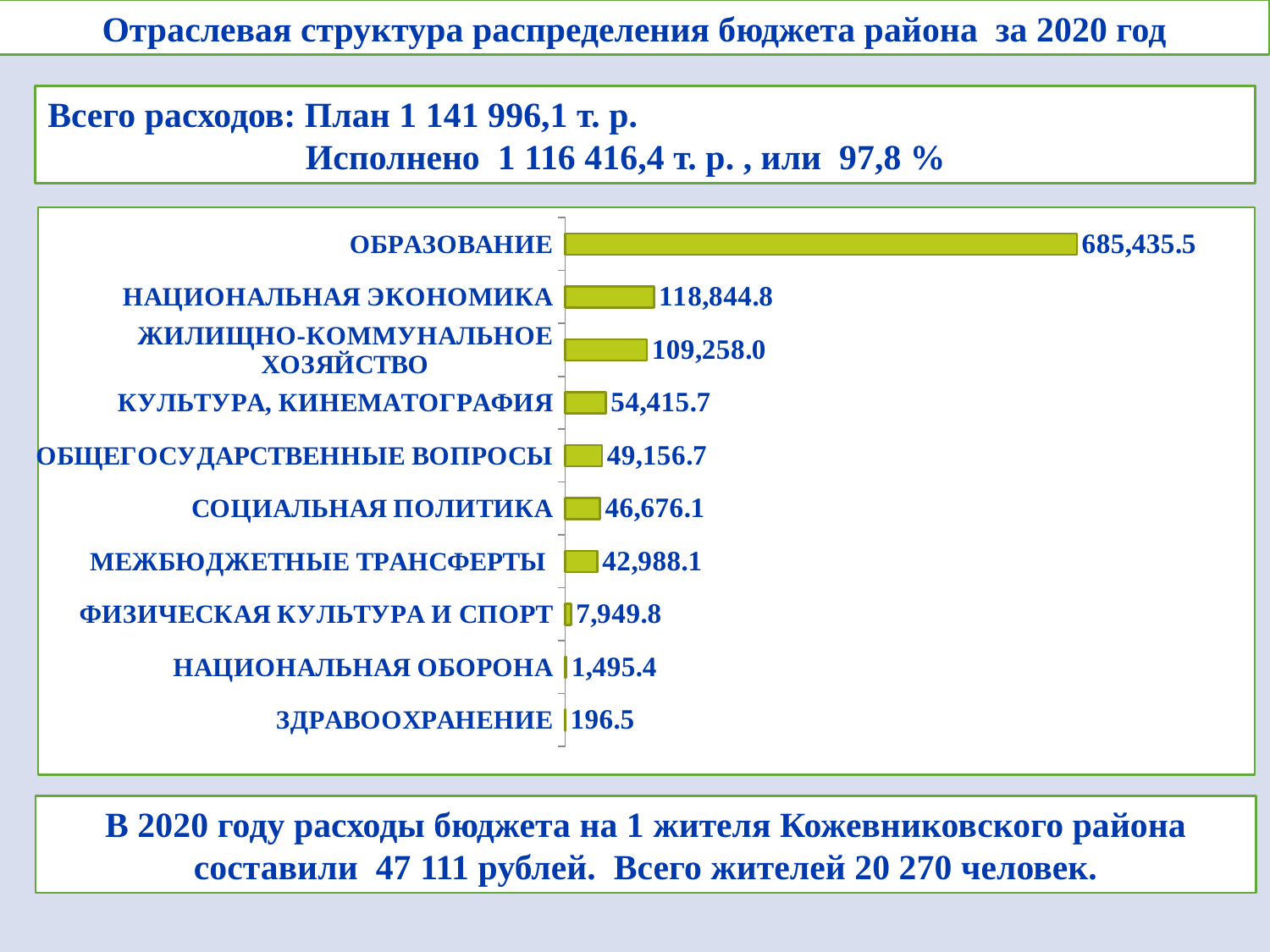
What is the difference between НАЦИОНАЛЬНАЯ ЭКОНОМИКА and ЖИЛИЩНО-КОММУНАЛЬНОЕ ХОЗЯЙСТВО? 9,586.8 Which category has the lowest value? ЗДРАВООХРАНЕНИЕ Do the values increase or decrease going from the top category to the bottom category? Decrease How many categories are shown in the chart? 10 Which is larger, СОЦИАЛЬНАЯ ПОЛИТИКА or ФИЗИЧЕСКАЯ КУЛЬТУРА И СПОРТ? СОЦИАЛЬНАЯ ПОЛИТИКА What is the value for ЗДРАВООХРАНЕНИЕ? 196.5 What is the difference between КУЛЬТУРА, КИНЕМАТОГРАФИЯ and ОБЩЕГОСУДАРСТВЕННЫЕ ВОПРОСЫ? 5,259.0 What kind of chart is shown on the slide? Bar chart What is the value for МЕЖБЮДЖЕТНЫЕ ТРАНСФЕРТЫ? 42,988.1 Which category has the highest value? ОБРАЗОВАНИЕ What is the value for ОБРАЗОВАНИЕ? 685,435.5 What is the value for ЖИЛИЩНО-КОММУНАЛЬНОЕ ХОЗЯЙСТВО? 109,258.0